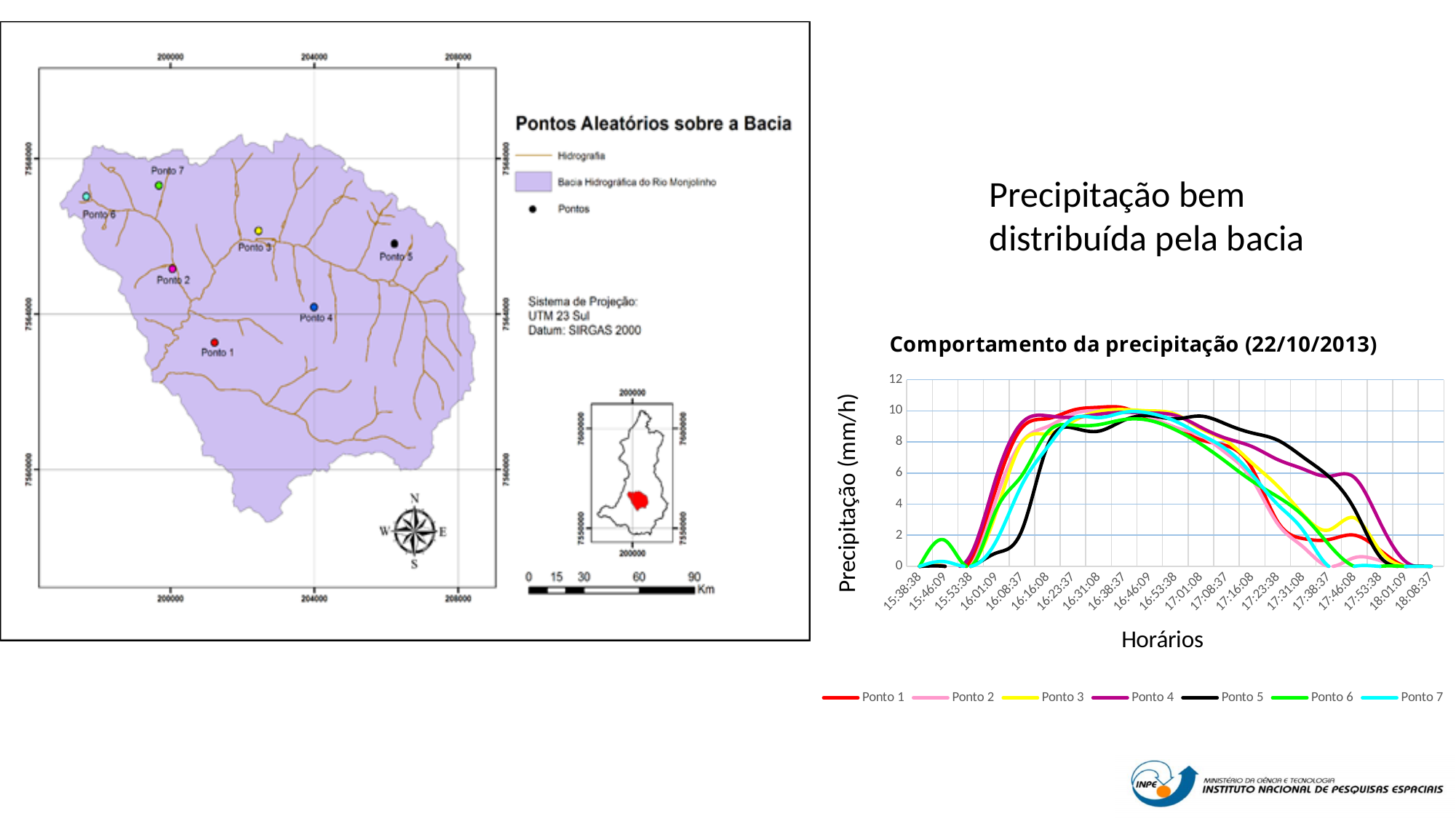
What kind of chart is 'Comportamento da precipitação (22/10/2013)'? line chart In the precipitation chart, is the value for Ponto 1 at 17:38:37 greater or less than 4? less In the precipitation chart, which series has the highest value at 17:01:08? Ponto 5 How many series does the legend of the precipitation chart list? 7 In the precipitation chart, is the value for Ponto 5 at 17:01:08 greater or less than 8? greater In the precipitation chart, which is larger at 17:38:37: Ponto 4 or Ponto 1? Ponto 4 In the precipitation chart, do the values rise or fall between 15:53:38 and 16:23:37? rise In the precipitation chart, is the value for Ponto 2 at 17:46:08 greater or less than 2? less What is the x-axis label of the precipitation chart? Horários How many time points are labelled on the x axis of the precipitation chart? 21 What is the y-axis label of the precipitation chart? Precipitação (mm/h)